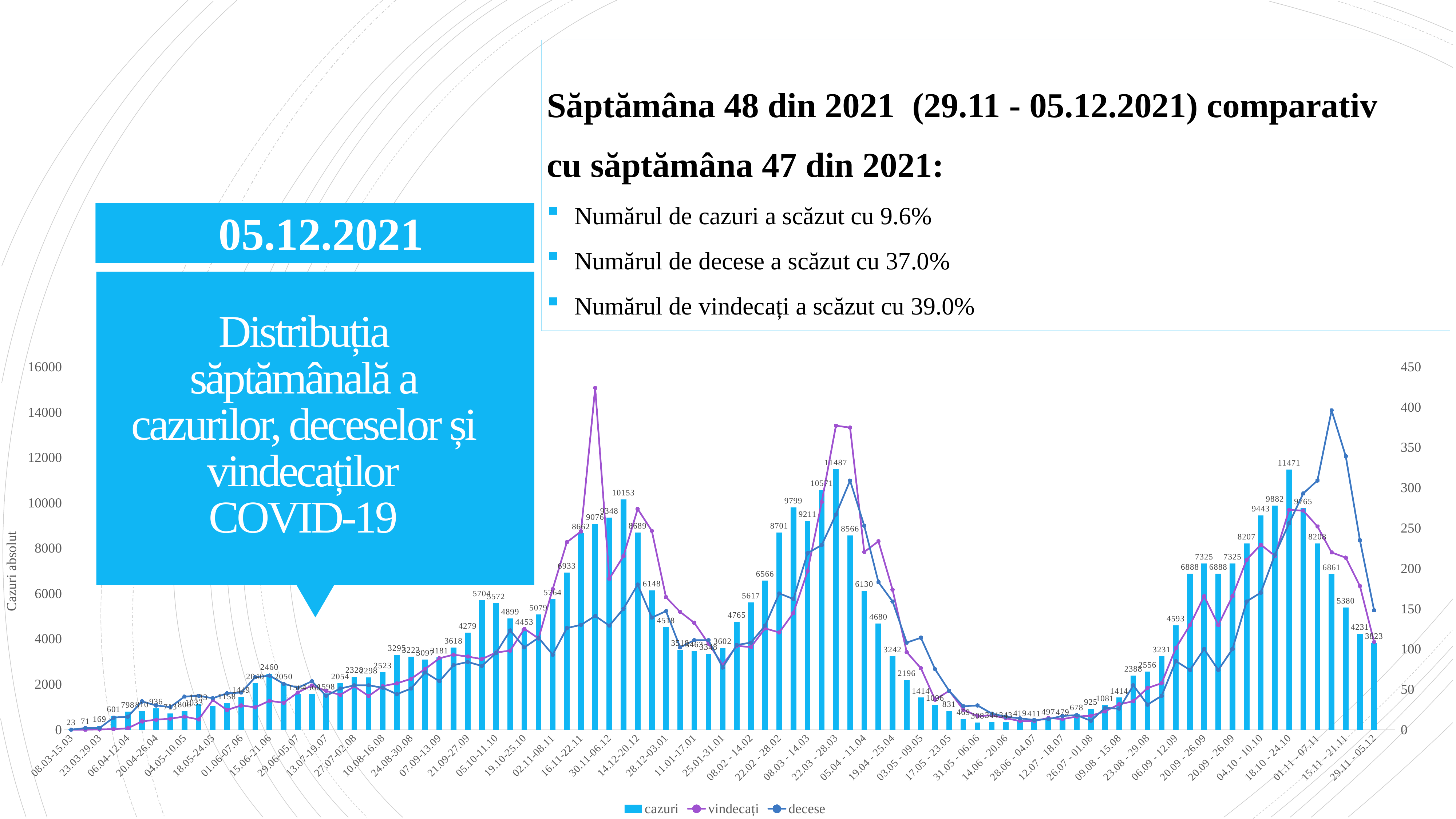
How many series does the legend list? 3 What is the number of cazuri (cases) for the week 29.11 - 05.12? 3823 What is the difference in cazuri between the week 18.10 - 24.10 and the week 29.11 - 05.12? 7648 Is the decese value for the week 29.11 - 05.12 greater or less than 200 on the right axis? less Which week has more cazuri, 04.10 - 10.10 or 18.10 - 24.10? 18.10 - 24.10 What is the difference in cazuri between the week 15.11 - 21.11 and the week 29.11 - 05.12? 1557 What is the number of cazuri for the first week shown, 08.03-15.03? 23 What kind of chart is shown on the slide? A combined bar and line chart What is the number of cazuri for the week 15.11 - 21.11? 5380 Which week has the lowest number of cazuri? 08.03-15.03 What is the number of cazuri for the week 18.10 - 24.10? 11471 Do the cazuri values rise or fall from the week 18.10 - 24.10 to the week 29.11 - 05.12? fall